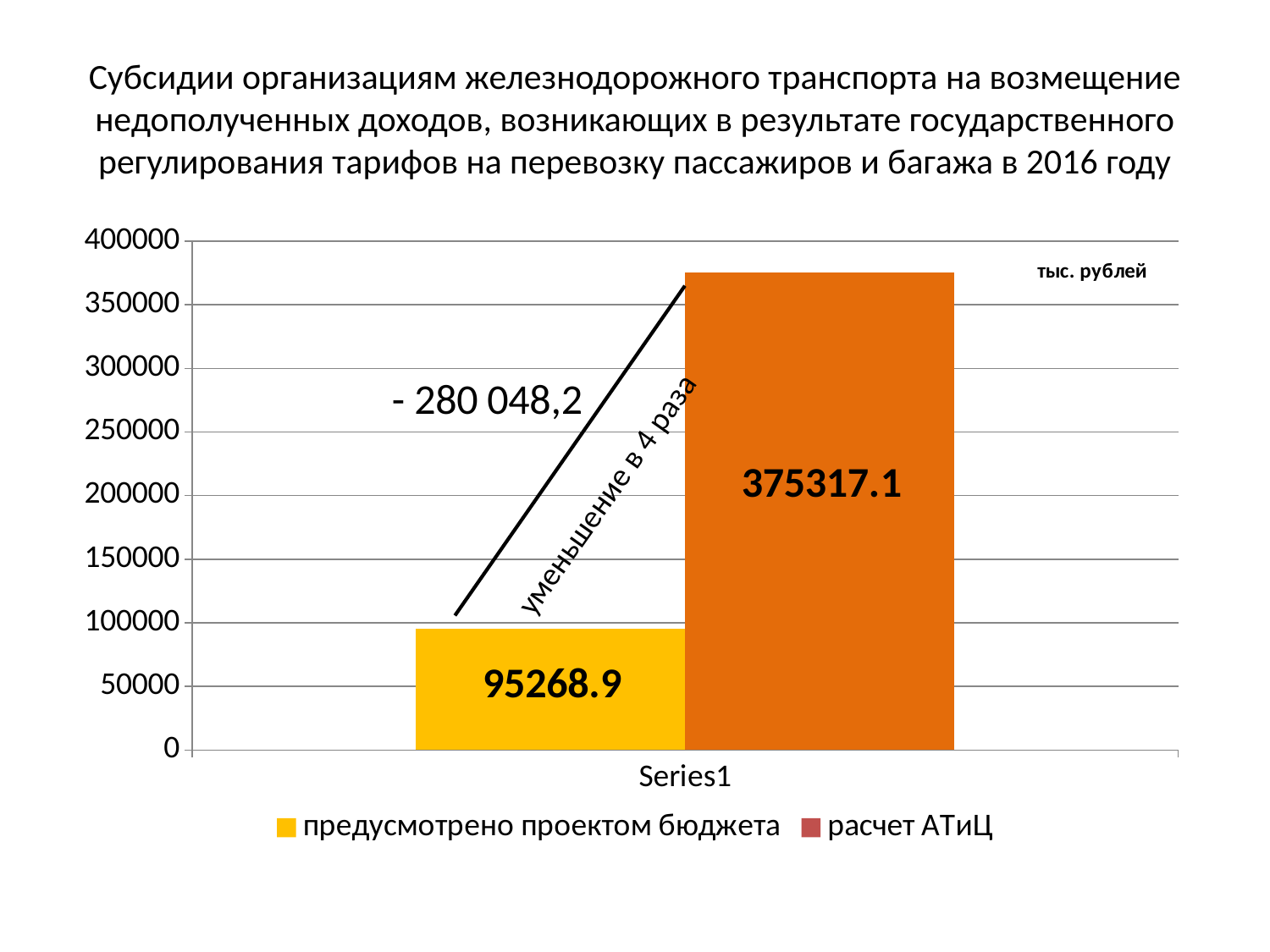
What is the value for the series "расчет АТиЦ"? 375317.1 What kind of chart is shown on the slide? bar chart How many series does the legend list? 2 Is the value for "расчет АТиЦ" greater or less than 350000? greater What unit of measurement is indicated on the chart? тыс. рублей Which series has the lower value? предусмотрено проектом бюджета What reduction factor is stated in the annotation between the two bars? уменьшение в 4 раза Which series has the higher value? расчет АТиЦ What is the value for the series "предусмотрено проектом бюджета"? 95268.9 Is the value for "предусмотрено проектом бюджета" greater or less than 100000? less What is the difference between the value for "расчет АТиЦ" and the value for "предусмотрено проектом бюджета"? 280048.2 Is the value for "предусмотрено проектом бюджета" larger or smaller than the value for "расчет АТиЦ"? smaller